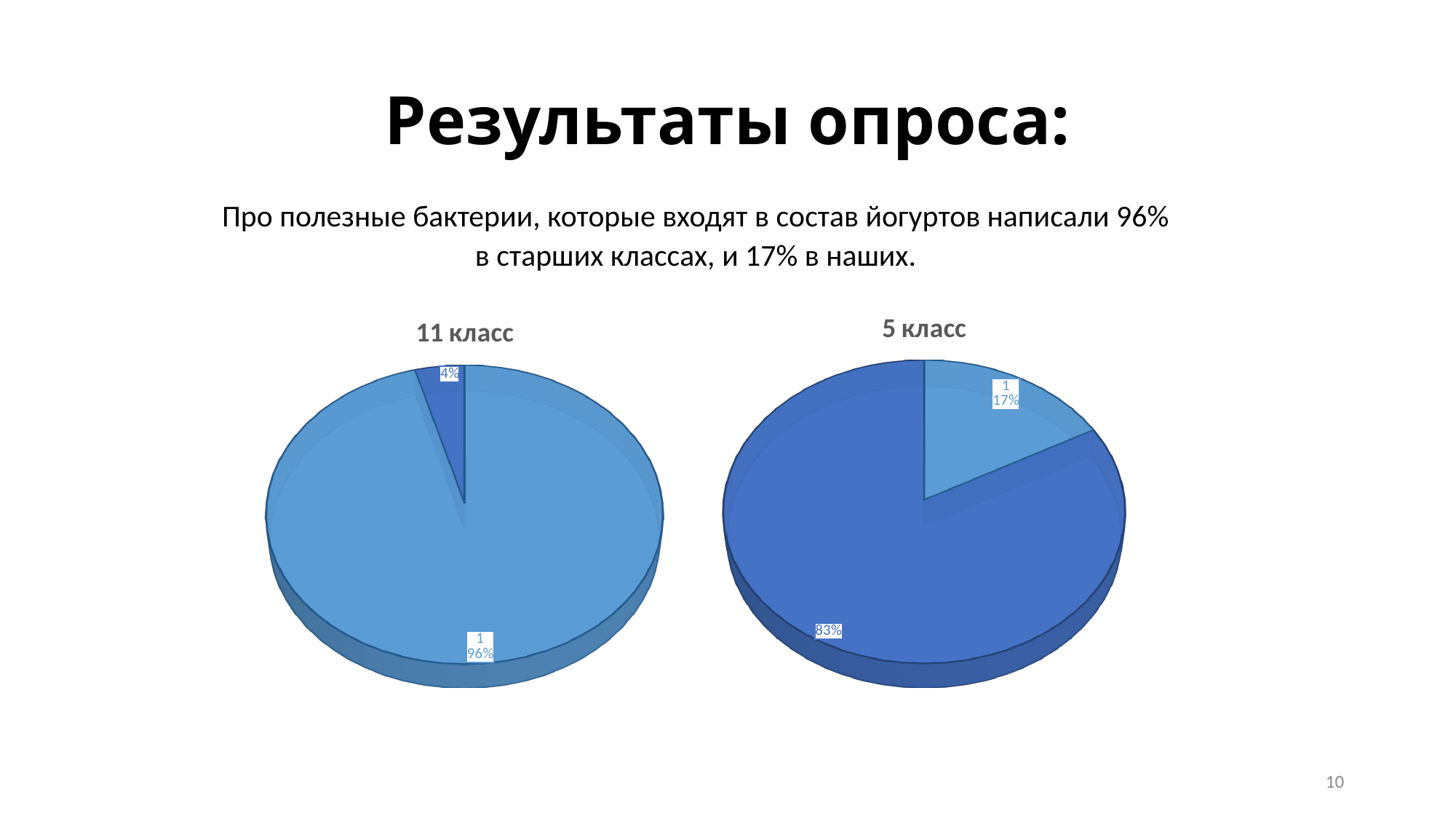
In the "5 класс" chart, what is the difference between the two slices' shares? 66% What is the title of the pie chart on the left? 11 класс In the "5 класс" chart, what share does the largest slice have? 83% How many slices does the "5 класс" pie chart have? 2 In the "11 класс" chart, what is the difference between the two slices' shares? 92% What type of chart is the "11 класс" chart? pie chart What type of chart is the "5 класс" chart? pie chart In the "11 класс" chart, what share does the largest slice have? 96% In the "11 класс" chart, what share does the smallest slice have? 4% Which chart has the larger smallest slice, "11 класс" or "5 класс"? 5 класс How many slices does the "11 класс" pie chart have? 2